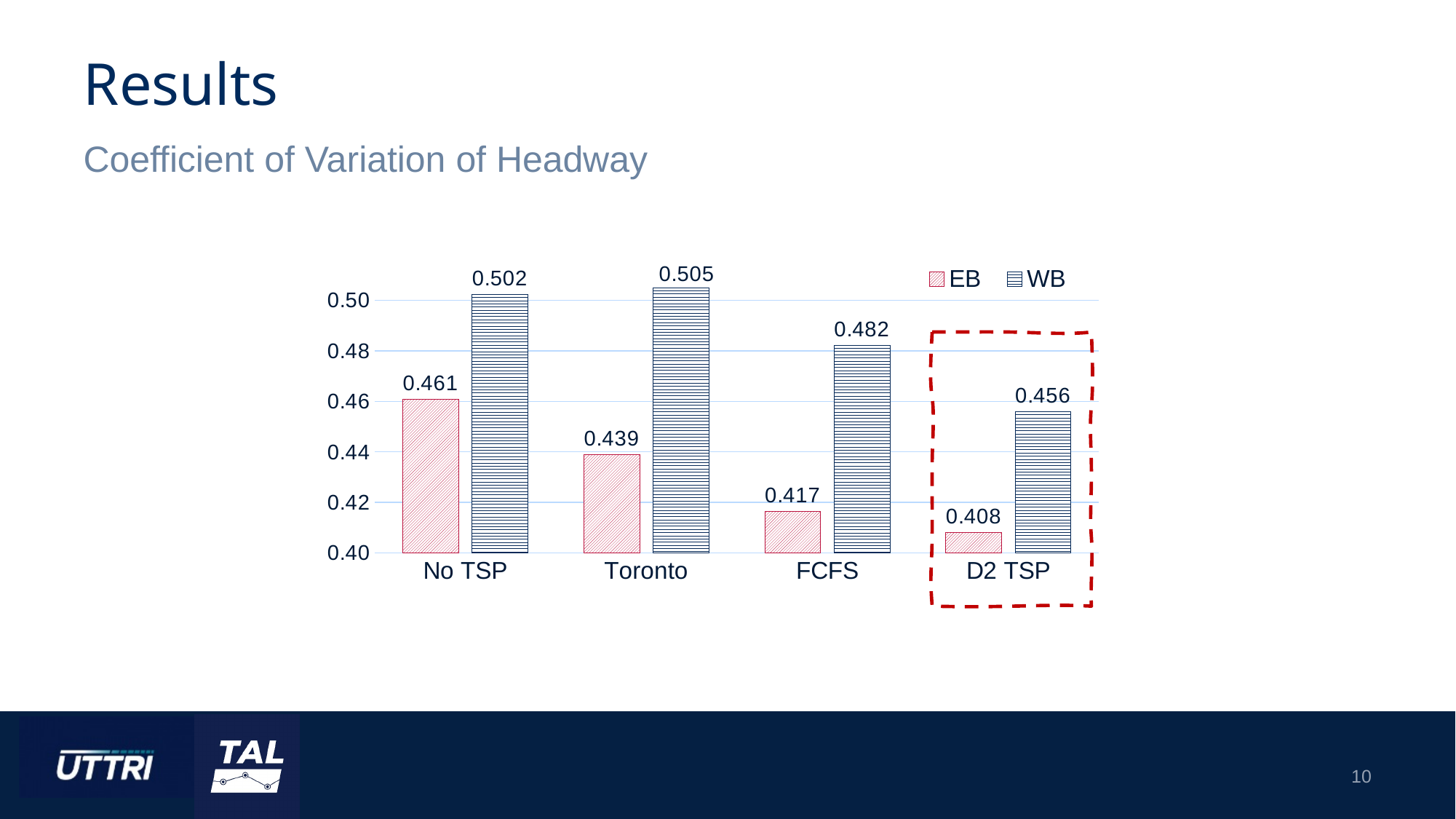
How many categories are shown on the x axis? 4 Which category is highlighted with a red dashed box? D2 TSP Which category has the highest WB value? Toronto What is the WB value for Toronto? 0.505 What is the EB value for D2 TSP? 0.408 Which category has the lowest EB value? D2 TSP What is the difference between the WB and EB values for No TSP? 0.041 What is the EB value for No TSP? 0.461 What kind of chart is shown on the slide? Bar chart What is the WB value for FCFS? 0.482 How many series does the legend list? 2 Which is larger, the EB value for Toronto or the EB value for FCFS? EB value for Toronto